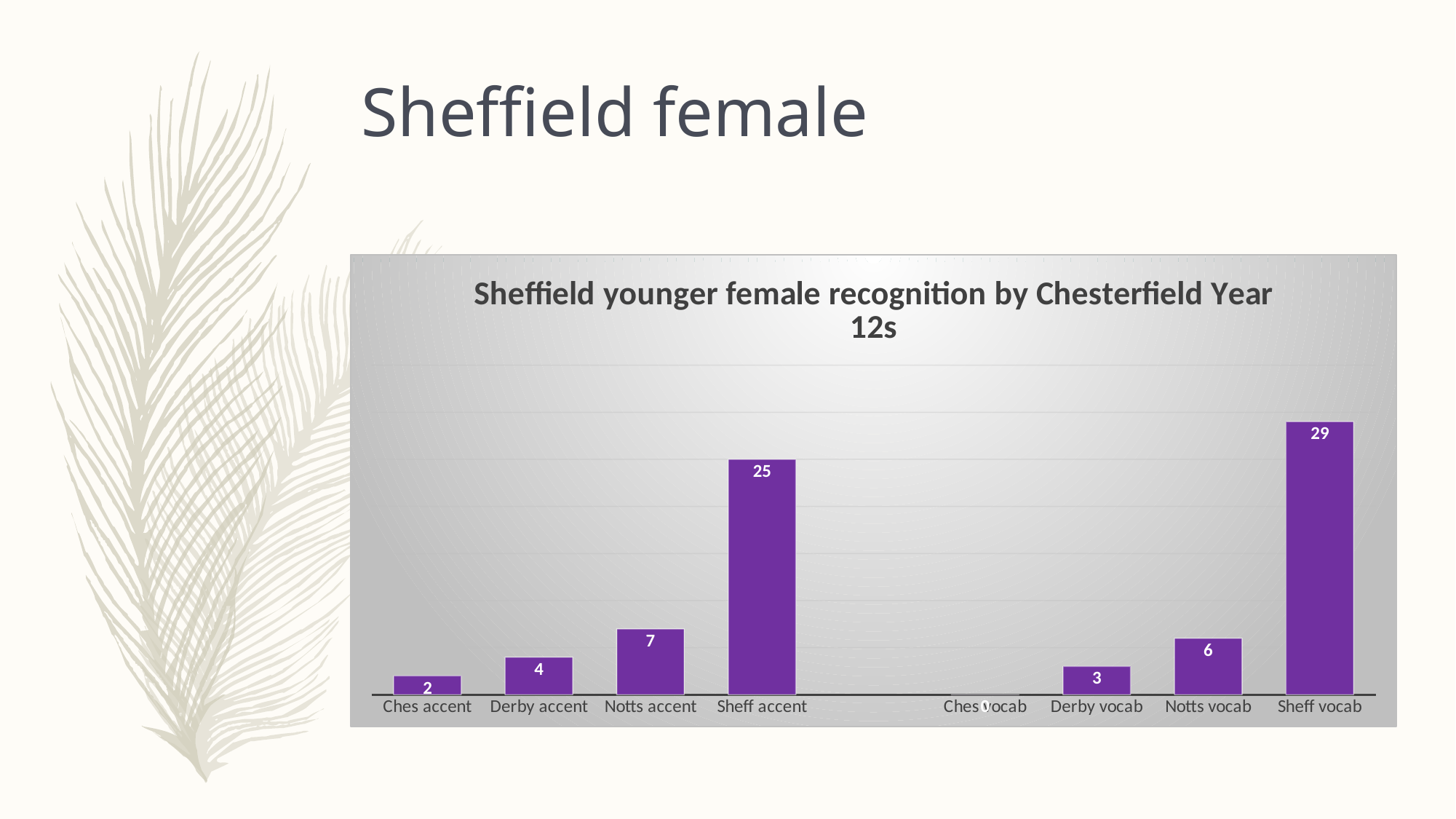
Which category has the highest value? Sheff vocab What is the value for Sheff accent? 25 What is the difference between the values for Sheff vocab and Sheff accent? 4 Which is larger, the value for Notts accent or the value for Notts vocab? Notts accent How many categories are shown on the x axis? 8 Which category has the lowest value? Ches vocab What is the value for Derby vocab? 3 What is the value for Sheff vocab? 29 What is the value for Notts accent? 7 What kind of chart is shown on the slide? Bar chart What is the title of the chart? Sheffield younger female recognition by Chesterfield Year 12s What is the value for Ches vocab? 0